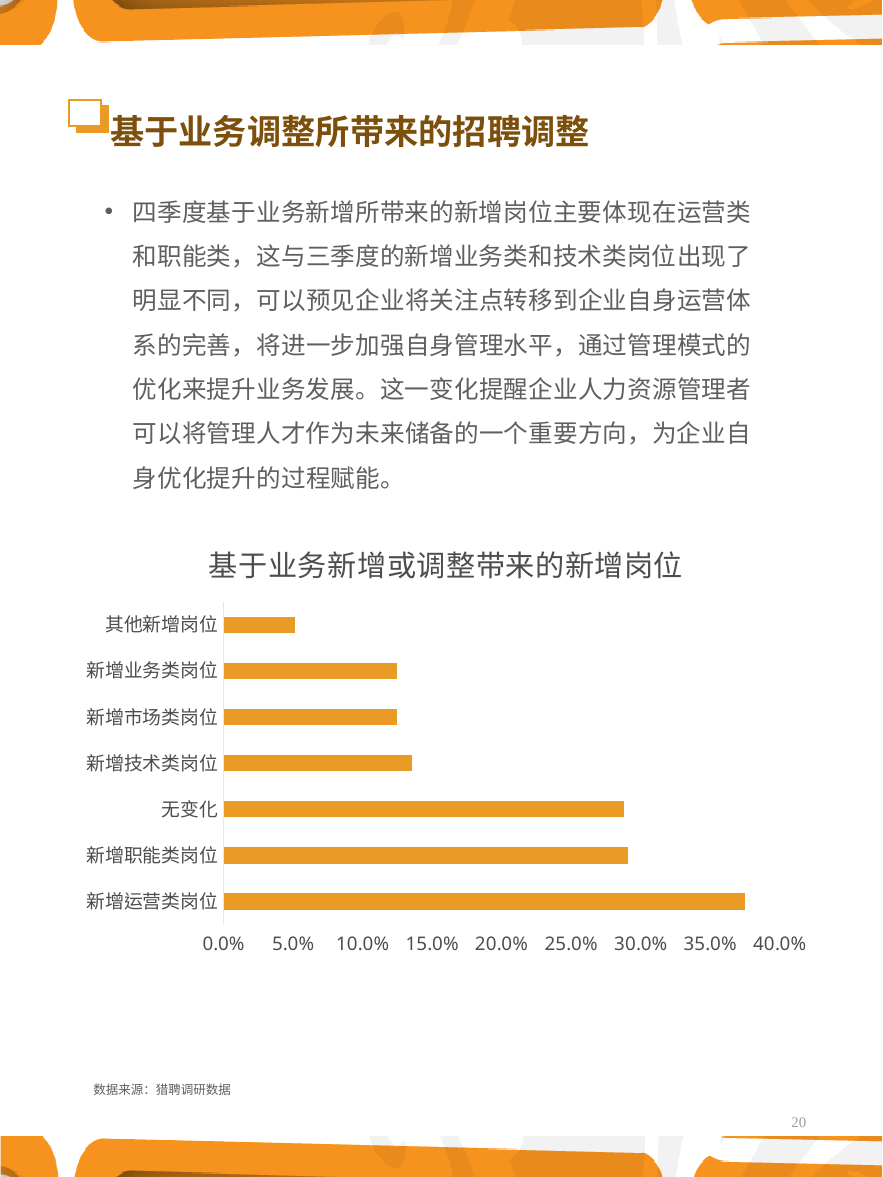
What is the title of the chart? 基于业务新增或调整带来的新增岗位 Which category has the highest value in the chart? 新增运营类岗位 Which is larger, the value for 新增运营类岗位 or the value for 无变化? 新增运营类岗位 Is the value for 新增职能类岗位 greater or less than 20.0%? greater What is the highest value shown on the horizontal axis of the chart? 40.0% What kind of chart is shown on the slide? bar chart Is the value for 无变化 greater or less than 25.0%? greater Is the value for 新增运营类岗位 greater or less than 35.0%? greater How many categories are plotted in the chart? 7 Which category has the lowest value in the chart? 其他新增岗位